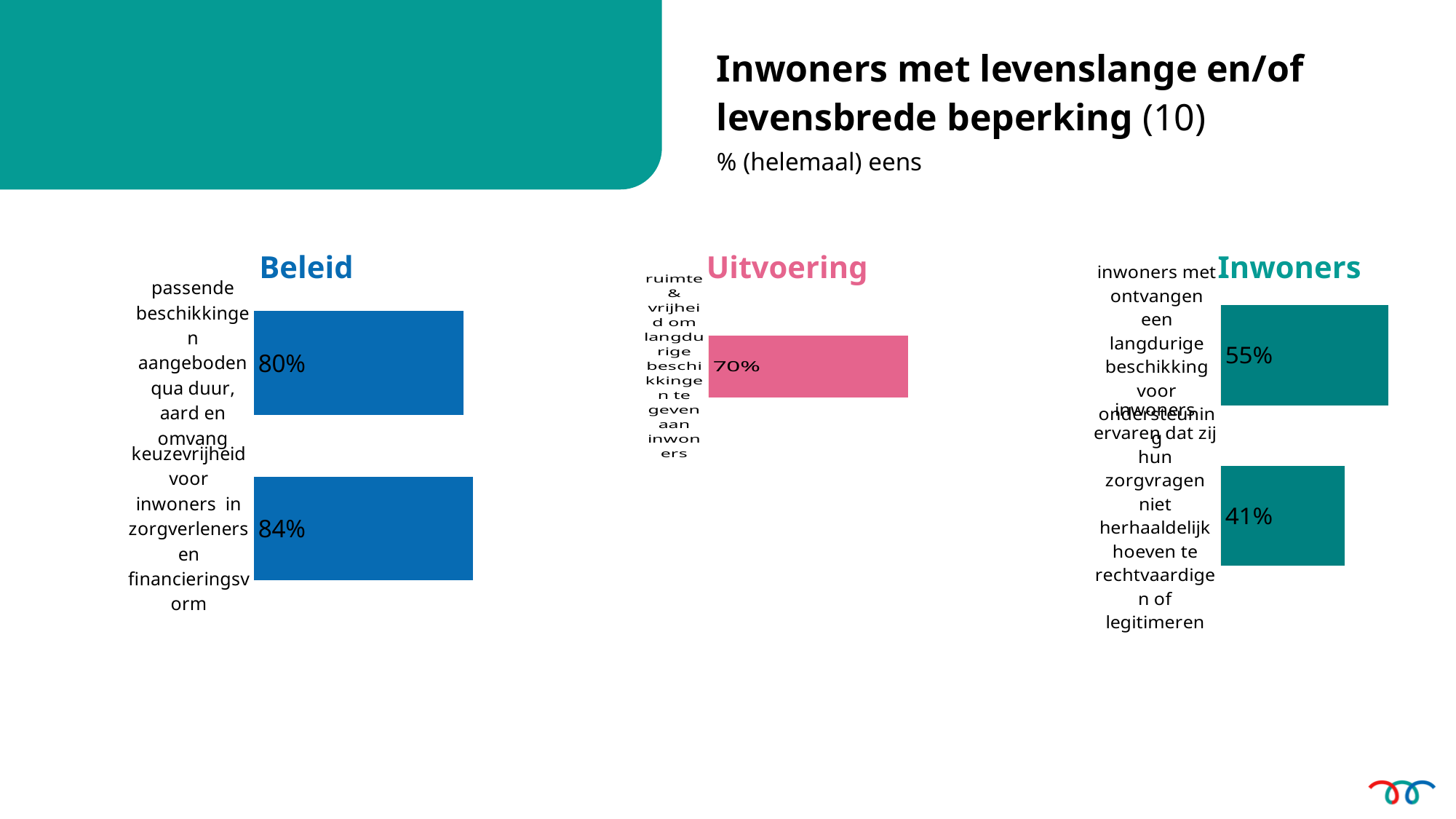
In the Beleid chart, which category has the highest value? keuzevrijheid voor inwoners in zorgverleners en financieringsvorm In the Inwoners chart, which bar has the lowest value? inwoners ervaren dat zij hun zorgvragen niet herhaaldelijk hoeven te rechtvaardigen of legitimeren Which is larger: the 70% bar in the Uitvoering chart or the 55% bar in the Inwoners chart? the Uitvoering bar (70%) In the Inwoners chart, what is the value for the bar about inwoners not having to repeatedly justify or legitimise their care requests ('ondersteuning ervaren dat zij hun zorgvragen niet herhaaldelijk hoeven te rechtvaardigen of legitimeren')? 41% In the Inwoners chart, what is the value of the top bar? 55% In the Beleid chart, what is the difference between the two bars? 4 percentage points How many bars does the Beleid chart show? 2 In the Beleid chart, what is the value for 'passende beschikkingen aangeboden qua duur, aard en omvang'? 80% What type of chart is the Uitvoering chart? bar chart In the Beleid chart, what is the value for 'keuzevrijheid voor inwoners in zorgverleners en financieringsvorm'? 84% In the Uitvoering chart, what is the value for 'ruimte & vrijheid om langdurige beschikkingen te geven aan inwoners'? 70% In the Inwoners chart, what is the difference between the top bar and the bottom bar? 14 percentage points